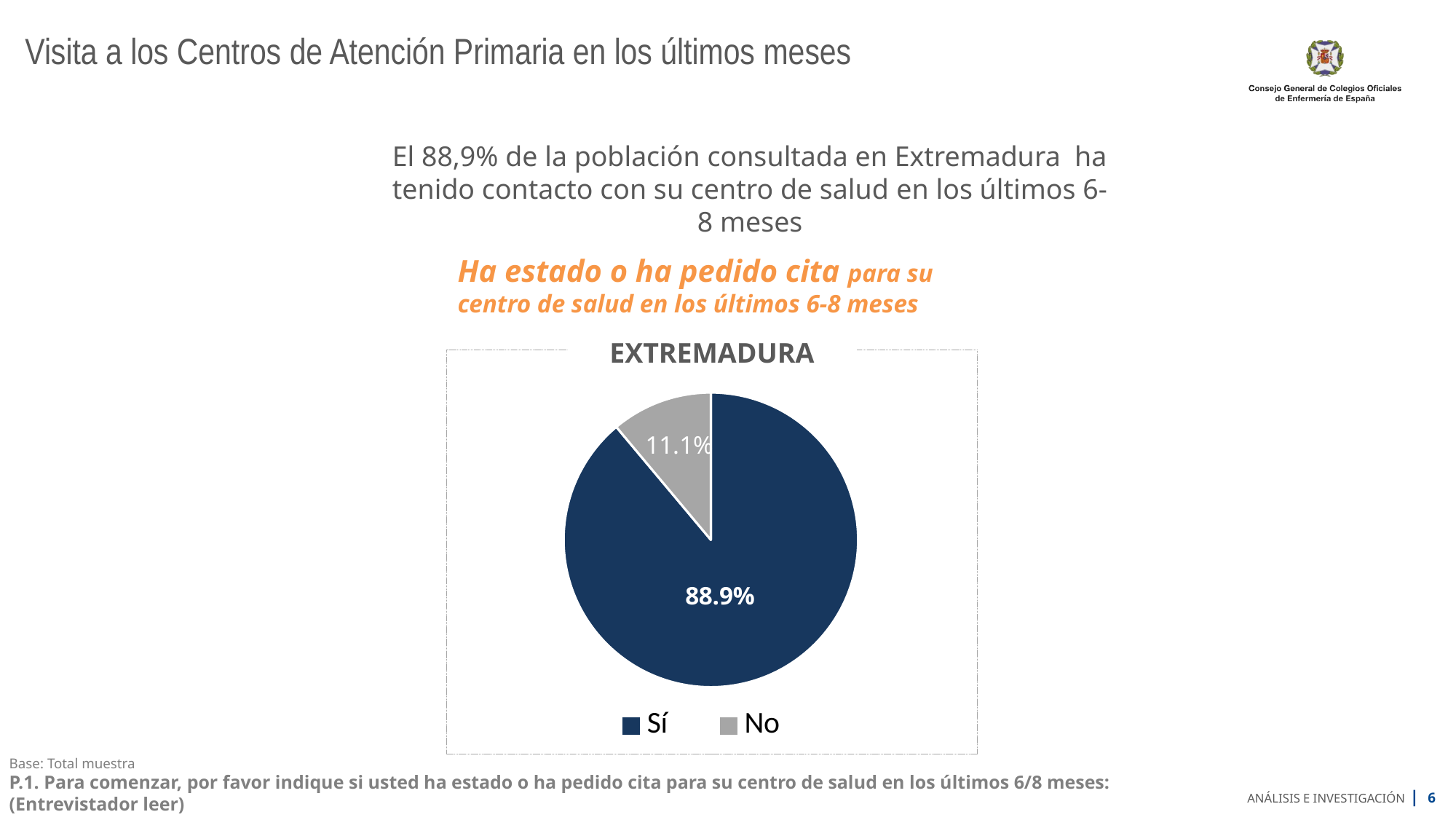
What percentage of the pie corresponds to "Sí"? 88.9% Which slice of the pie is the largest? Sí What colour is the "Sí" slice in the pie chart? dark blue Which is larger, the "Sí" slice or the "No" slice? Sí How many entries does the legend list? 2 What kind of chart is shown on the slide? pie chart Which slice of the pie is the smallest? No How many slices does the pie chart have? 2 What is the difference in percentage points between the "Sí" and "No" slices? 77.8 What is the title of the chart? EXTREMADURA What percentage of the pie corresponds to "No"? 11.1% What is the combined share of the "Sí" and "No" slices? 100%